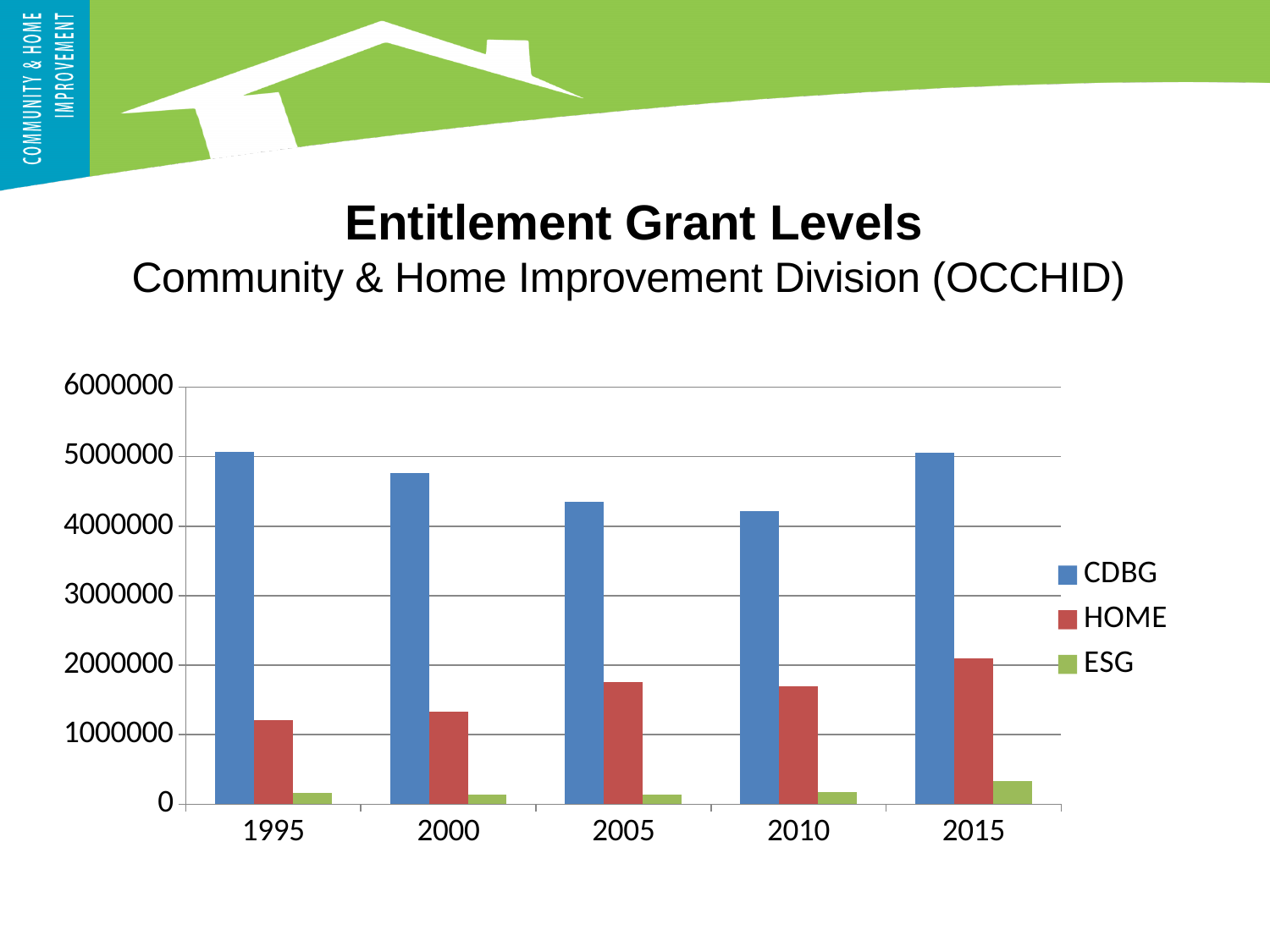
Does the HOME value rise or fall between 1995 and 2015? rise How many years are shown on the x axis? 5 How many series does the legend list? 3 Is the CDBG value for 2000 greater or less than 4000000? greater Is the HOME value for 2005 greater or less than 2000000? less In which year is the ESG value highest? 2015 What are the three series listed in the legend? CDBG, HOME, ESG Is the ESG value for 2015 greater or less than 1000000? less Which is larger, the CDBG value for 2000 or the CDBG value for 2005? 2000 In which year is the HOME value highest? 2015 What kind of chart is shown on the slide? bar chart Which series is shown in blue? CDBG